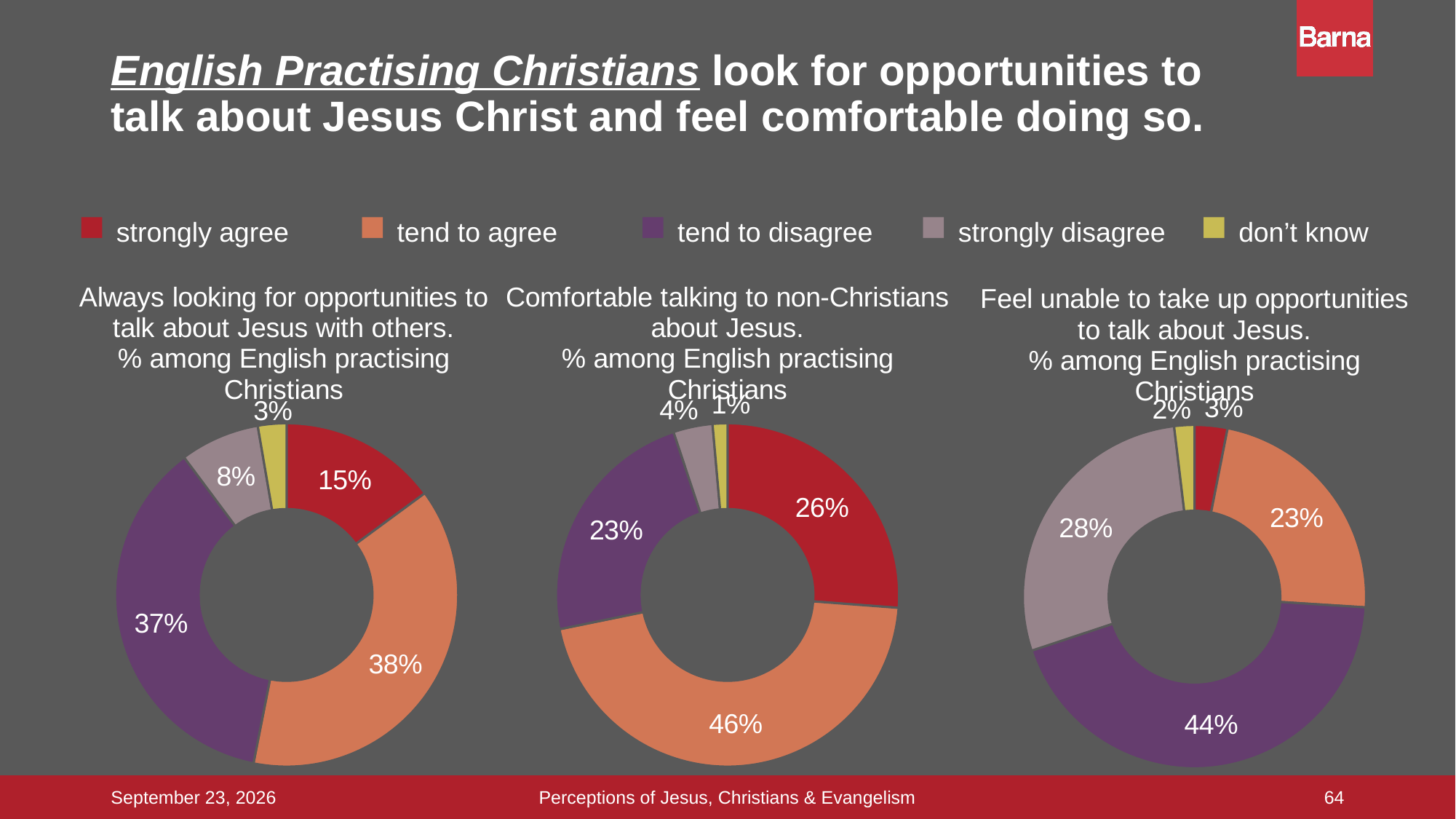
In the 'Feel unable to take up opportunities to talk about Jesus' chart, what is the difference between 'strongly disagree' and 'tend to agree'? 5% In the 'Always looking for opportunities to talk about Jesus with others' chart, what percentage is 'tend to agree'? 38% How many response categories does the legend list? 5 In the 'Feel unable to take up opportunities to talk about Jesus' chart, what percentage is 'tend to disagree'? 44% In the 'Comfortable talking to non-Christians about Jesus' chart, what percentage is 'strongly agree'? 26% In the 'Feel unable to take up opportunities to talk about Jesus' chart, which is larger: 'strongly agree' or 'tend to agree'? tend to agree What kind of chart is used on this slide? doughnut chart In the 'Comfortable talking to non-Christians about Jesus' chart, which response has the smallest share? don't know In the 'Always looking for opportunities to talk about Jesus with others' chart, what percentage is 'strongly disagree'? 8% In the 'Always looking for opportunities to talk about Jesus with others' chart, what is the combined share of 'strongly agree' and 'tend to agree'? 53% In the 'Comfortable talking to non-Christians about Jesus' chart, which response has the largest share? tend to agree Which colour represents 'don't know' in the legend? yellow